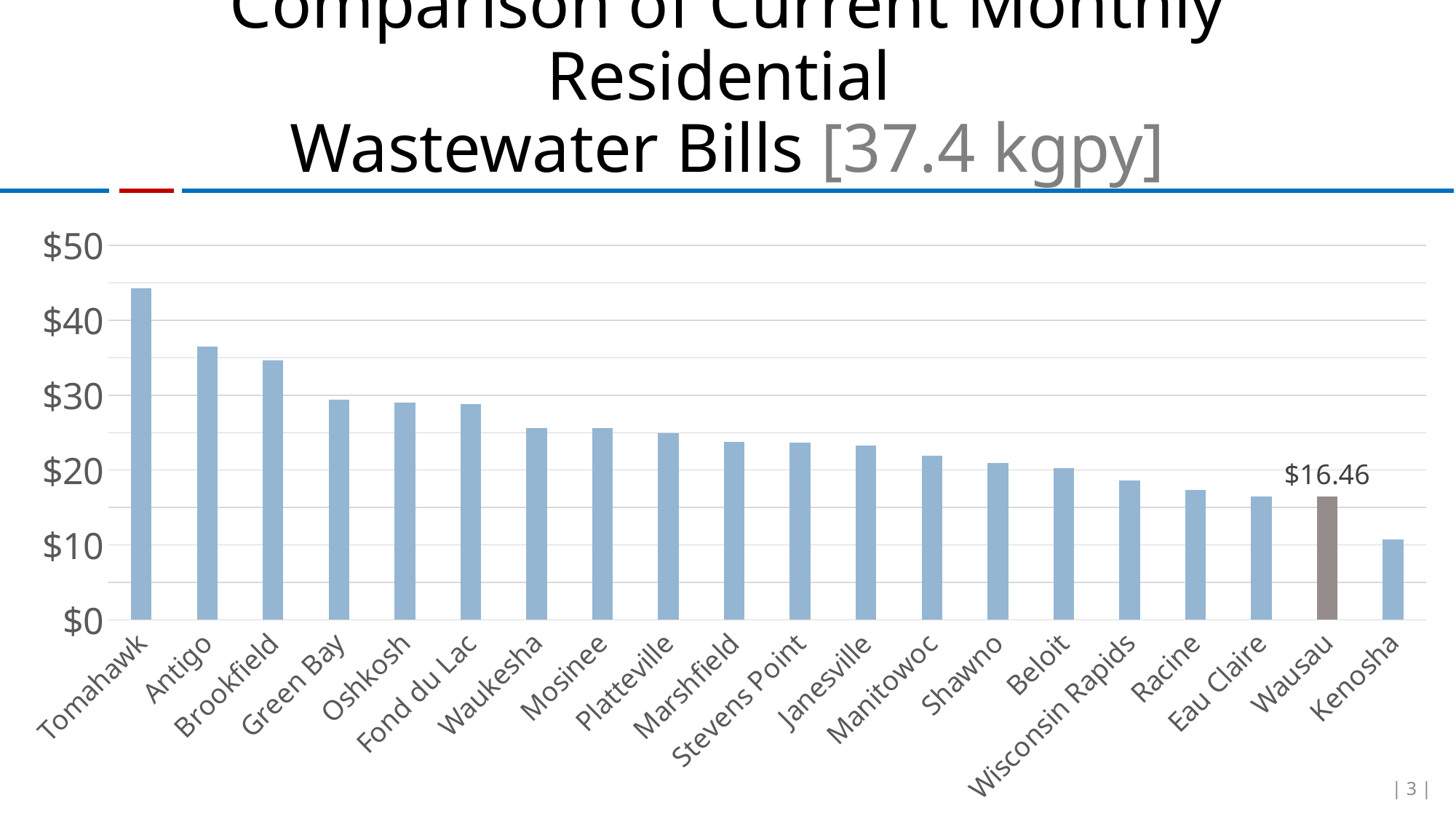
What kind of chart is shown on the slide? Bar chart How many cities are shown on the chart? 20 Which city's bar is shown in a different colour from the others? Wausau Is the value for Kenosha greater or less than $20? less Is the value for Tomahawk greater or less than $40? greater Is the value for Racine greater or less than $20? less Which city has the highest monthly residential wastewater bill? Tomahawk Which has a higher monthly bill, Tomahawk or Antigo? Tomahawk What is the monthly residential wastewater bill shown for Wausau? $16.46 Do the bar values rise or fall from left to right across the chart? Fall Which city has the lowest monthly residential wastewater bill? Kenosha